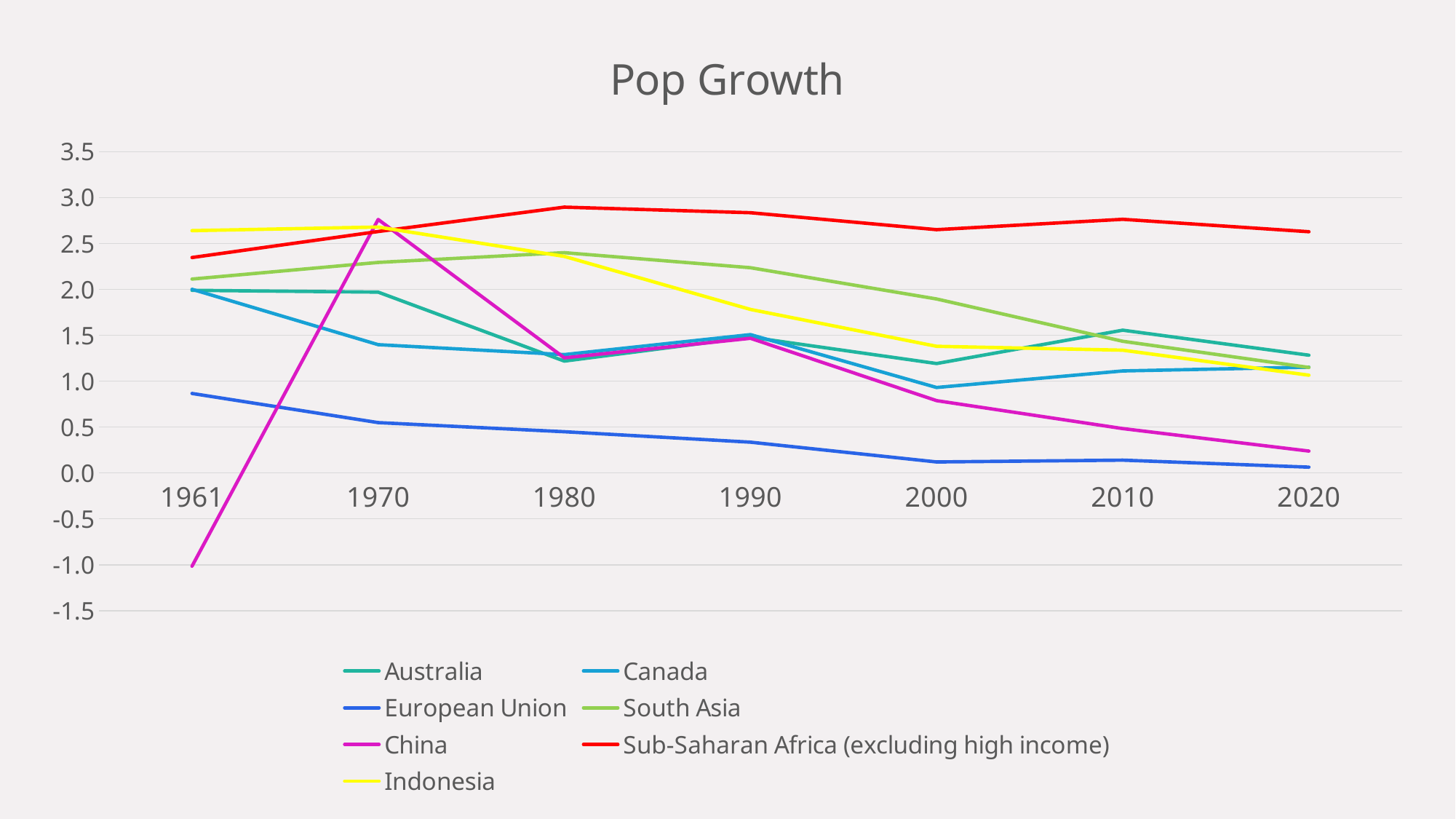
Which series has the highest value in 1961? Indonesia In 2000, which is larger: the value for South Asia or the value for Canada? South Asia How many series does the legend list? 7 How many years are shown on the x axis? 7 Does the European Union line rise or fall from 1961 to 2020? fall Which series has the highest value in 2020? Sub-Saharan Africa (excluding high income) What kind of chart is shown on the slide? line chart Which series has the lowest value in 2020? European Union Which series has the lowest value in 1961? China What is the title of the chart? Pop Growth Is the value for China in 1961 greater or less than 0.0? less Is the value for Sub-Saharan Africa (excluding high income) in 1980 greater or less than 2.5? greater